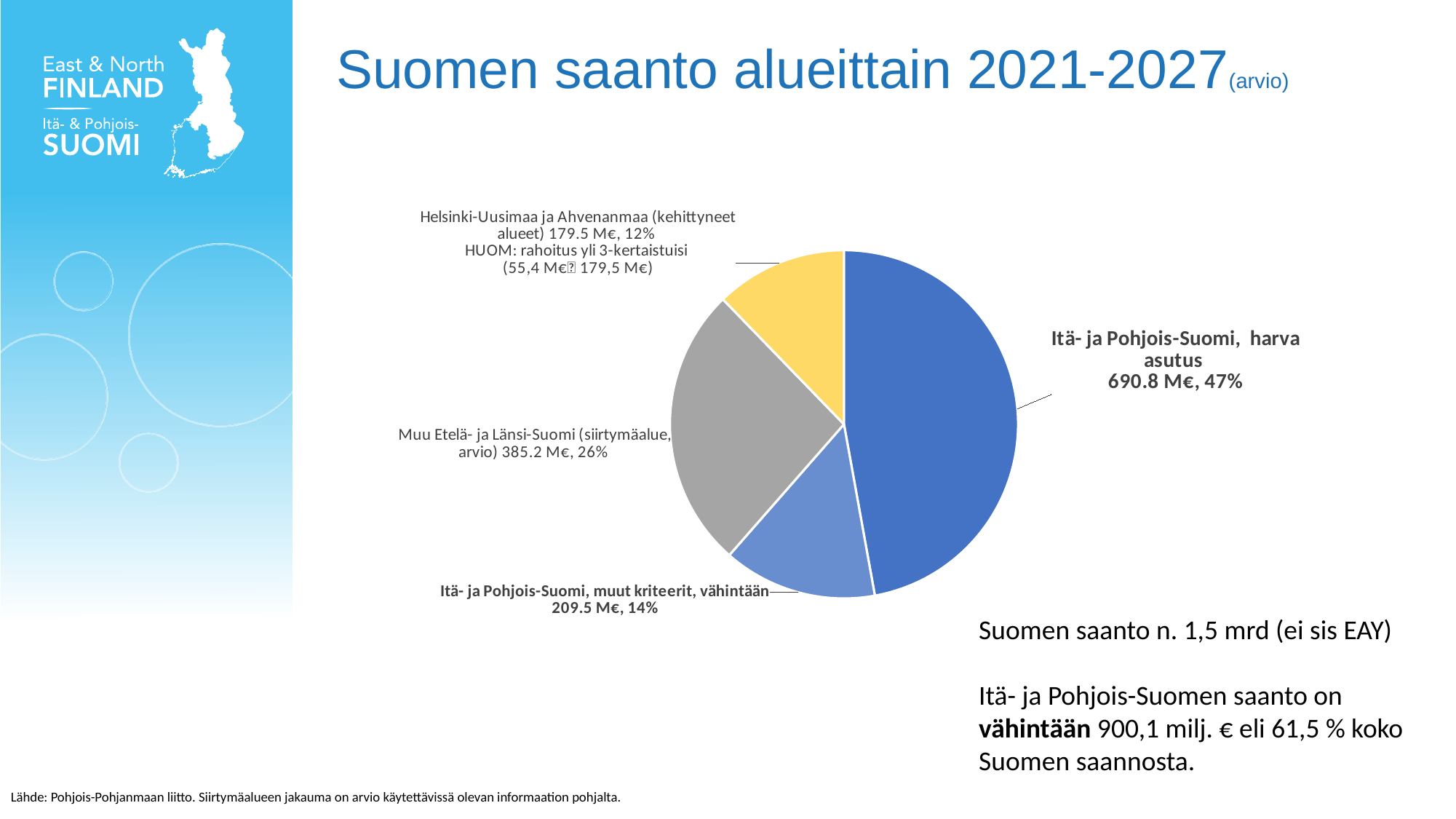
What is the value for Itä- ja Pohjois-Suomi, harva asutus? 690.8 M€ Which slice of the pie chart is the smallest? Helsinki-Uusimaa ja Ahvenanmaa (kehittyneet alueet) What share of the pie does Itä- ja Pohjois-Suomi, muut kriteerit, vähintään represent? 14% What share of the pie does Itä- ja Pohjois-Suomi, harva asutus represent? 47% What type of chart is shown on the slide? Pie chart What is the value for Helsinki-Uusimaa ja Ahvenanmaa (kehittyneet alueet)? 179.5 M€ Which slice of the pie chart is the largest? Itä- ja Pohjois-Suomi, harva asutus What is the value for Muu Etelä- ja Länsi-Suomi (siirtymäalue, arvio)? 385.2 M€ What is the title of the chart on the slide? Suomen saanto alueittain 2021-2027 (arvio) What is the difference in M€ between Itä- ja Pohjois-Suomi, harva asutus and Muu Etelä- ja Länsi-Suomi (siirtymäalue, arvio)? 305.6 M€ Which is larger: Muu Etelä- ja Länsi-Suomi (siirtymäalue, arvio) or Itä- ja Pohjois-Suomi, muut kriteerit, vähintään? Muu Etelä- ja Länsi-Suomi (siirtymäalue, arvio) How many slices does the pie chart have? 4